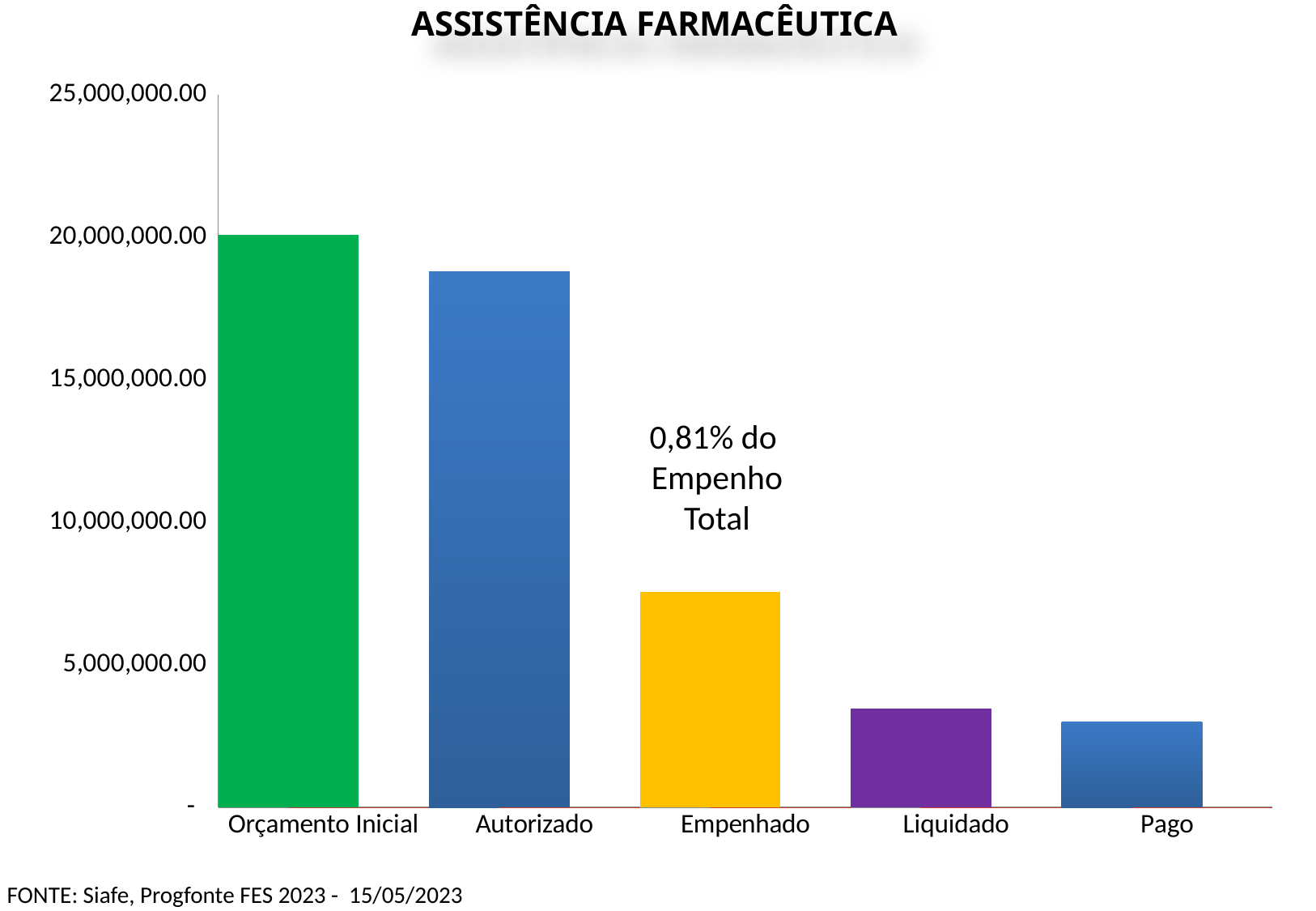
How many categories are shown on the x axis? 5 Is the value for Autorizado greater or less than 20,000,000.00? less Is the value for Empenhado greater or less than 5,000,000.00? greater Which category has the highest value? Orçamento Inicial Is the value for Liquidado greater or less than 5,000,000.00? less What type of chart is shown on the slide? bar chart Do the values rise or fall from Orçamento Inicial to Pago along the x axis? fall Which category has the lowest value? Pago Which is larger, the value for Liquidado or the value for Pago? Liquidado What percentage of the total Empenho does the annotation above the Empenhado bar state? 0,81% What is the title of the chart? ASSISTÊNCIA FARMACÊUTICA